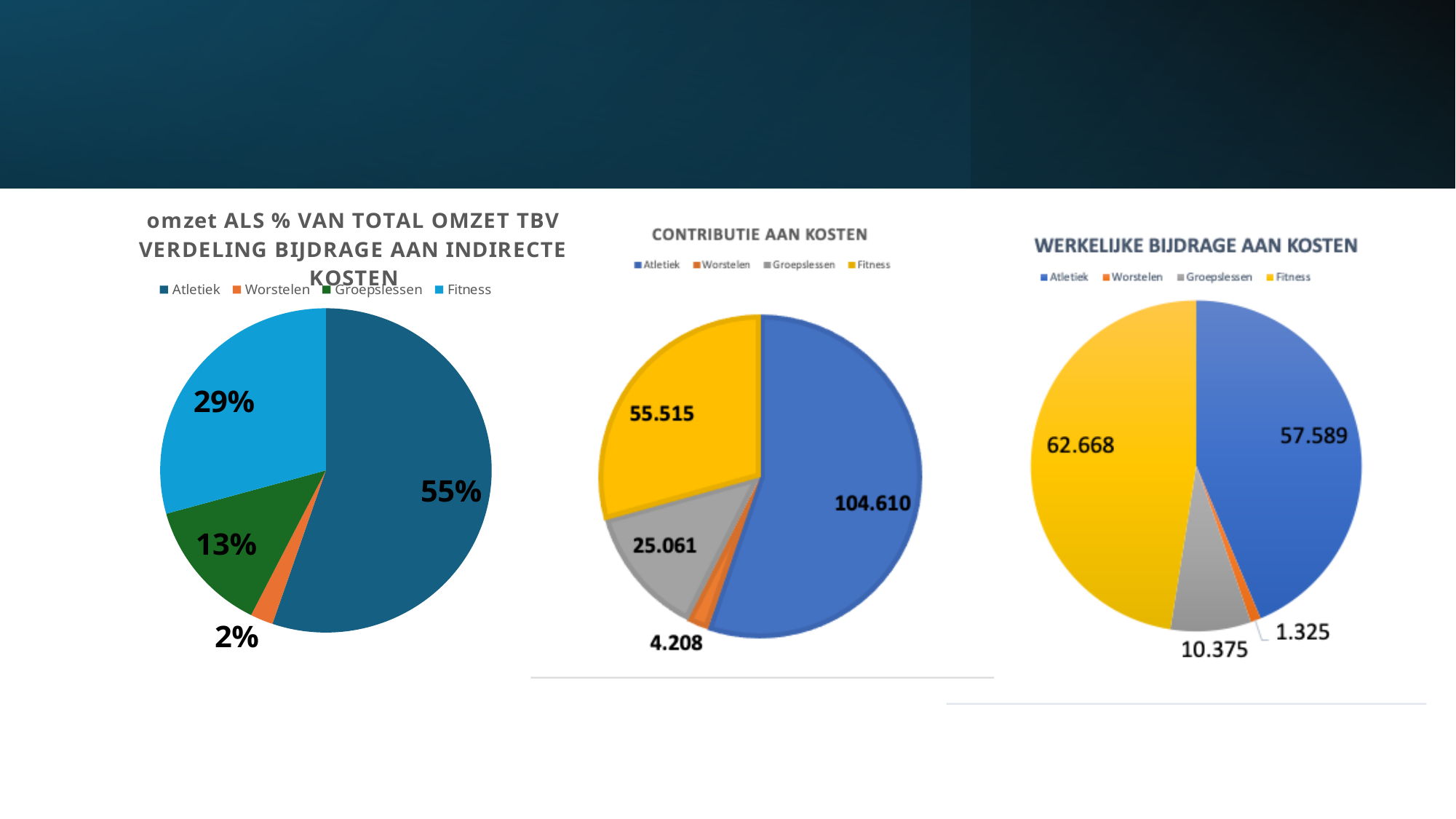
In the right chart (WERKELIJKE BIJDRAGE AAN KOSTEN), what is the value for Groepslessen? 10.375 In the left chart (omzet ALS % VAN TOTAL OMZET), which category has the smallest share? Worstelen In the middle chart (CONTRIBUTIE AAN KOSTEN), what is the difference between Atletiek and Fitness? 49.095 In the left chart (omzet ALS % VAN TOTAL OMZET), what percentage is shown for Atletiek? 55% In the middle chart (CONTRIBUTIE AAN KOSTEN), which category has the largest value? Atletiek In the left chart (omzet ALS % VAN TOTAL OMZET), how many percentage points larger is Atletiek than Fitness? 26 In the left chart (omzet ALS % VAN TOTAL OMZET), what percentage is shown for Groepslessen? 13% In the right chart (WERKELIJKE BIJDRAGE AAN KOSTEN), what is the value for Fitness? 62.668 What type of chart is the right chart (WERKELIJKE BIJDRAGE AAN KOSTEN)? Pie chart In the middle chart (CONTRIBUTIE AAN KOSTEN), what is the value for Worstelen? 4.208 In the right chart (WERKELIJKE BIJDRAGE AAN KOSTEN), which is larger, Fitness or Atletiek? Fitness In the middle chart (CONTRIBUTIE AAN KOSTEN), what is the value for Atletiek? 104.610